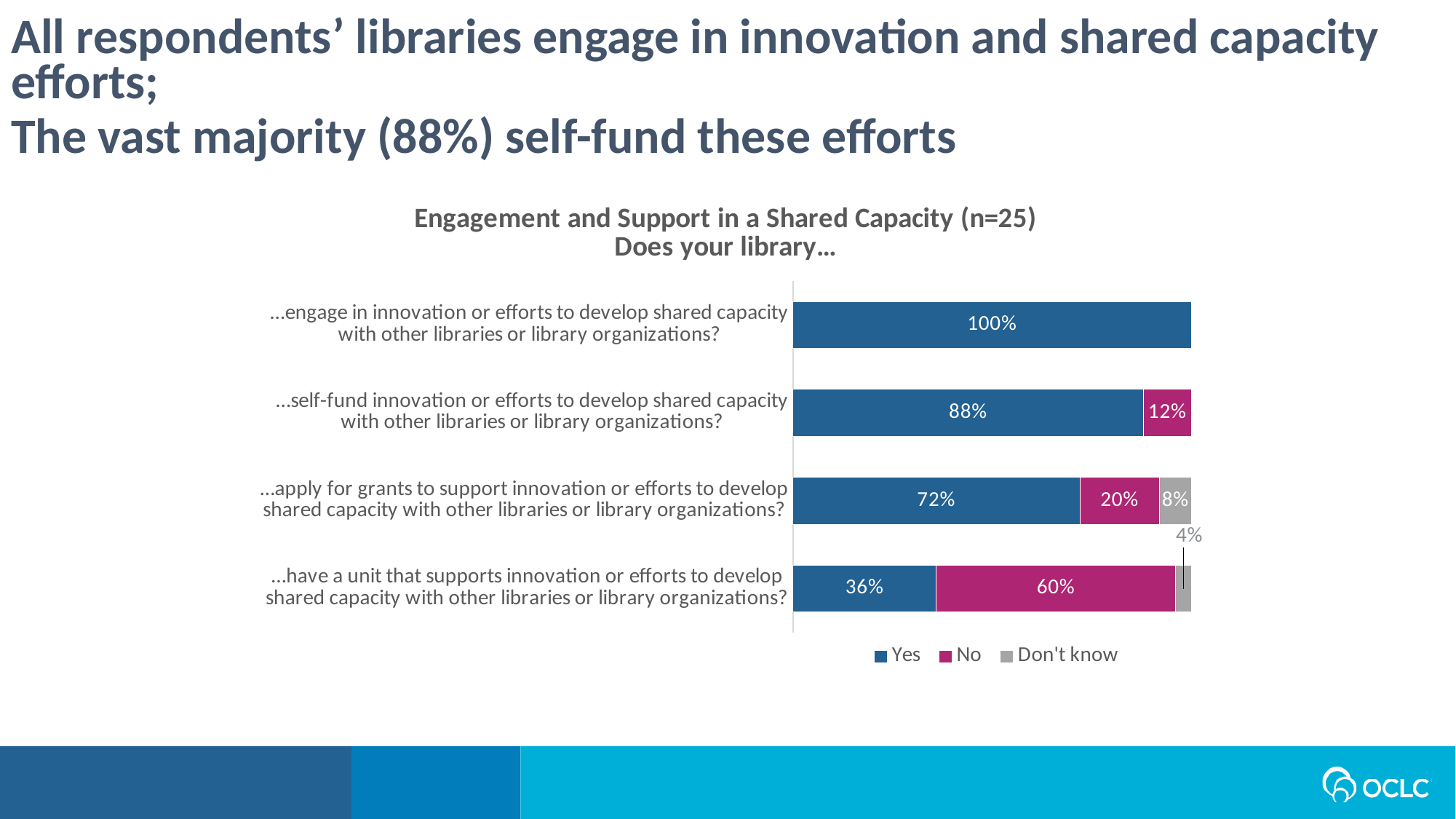
What percentage of respondents answered No to whether their library has a unit that supports innovation or efforts to develop shared capacity? 60% What percentage of respondents answered Don't know to whether their library has a unit that supports innovation or efforts to develop shared capacity? 4% What percentage of respondents answered Yes to whether their library engages in innovation or efforts to develop shared capacity with other libraries or library organizations? 100% Which question has the lowest Yes percentage? ...have a unit that supports innovation or efforts to develop shared capacity with other libraries or library organizations? What kind of chart is shown on the slide? Stacked bar chart What is the difference between the Yes percentage for self-funding innovation efforts and the Yes percentage for applying for grants? 16% What is the sample size (n) given in the chart title? 25 Which is larger for the question about having a unit that supports innovation efforts: the Yes percentage or the No percentage? No How many questions (categories) are shown in the chart? 4 What percentage of respondents answered No to whether their library self-funds innovation or efforts to develop shared capacity? 12% What percentage of respondents answered Don't know to whether their library applies for grants to support innovation or efforts to develop shared capacity? 8% How many series does the legend list? 3